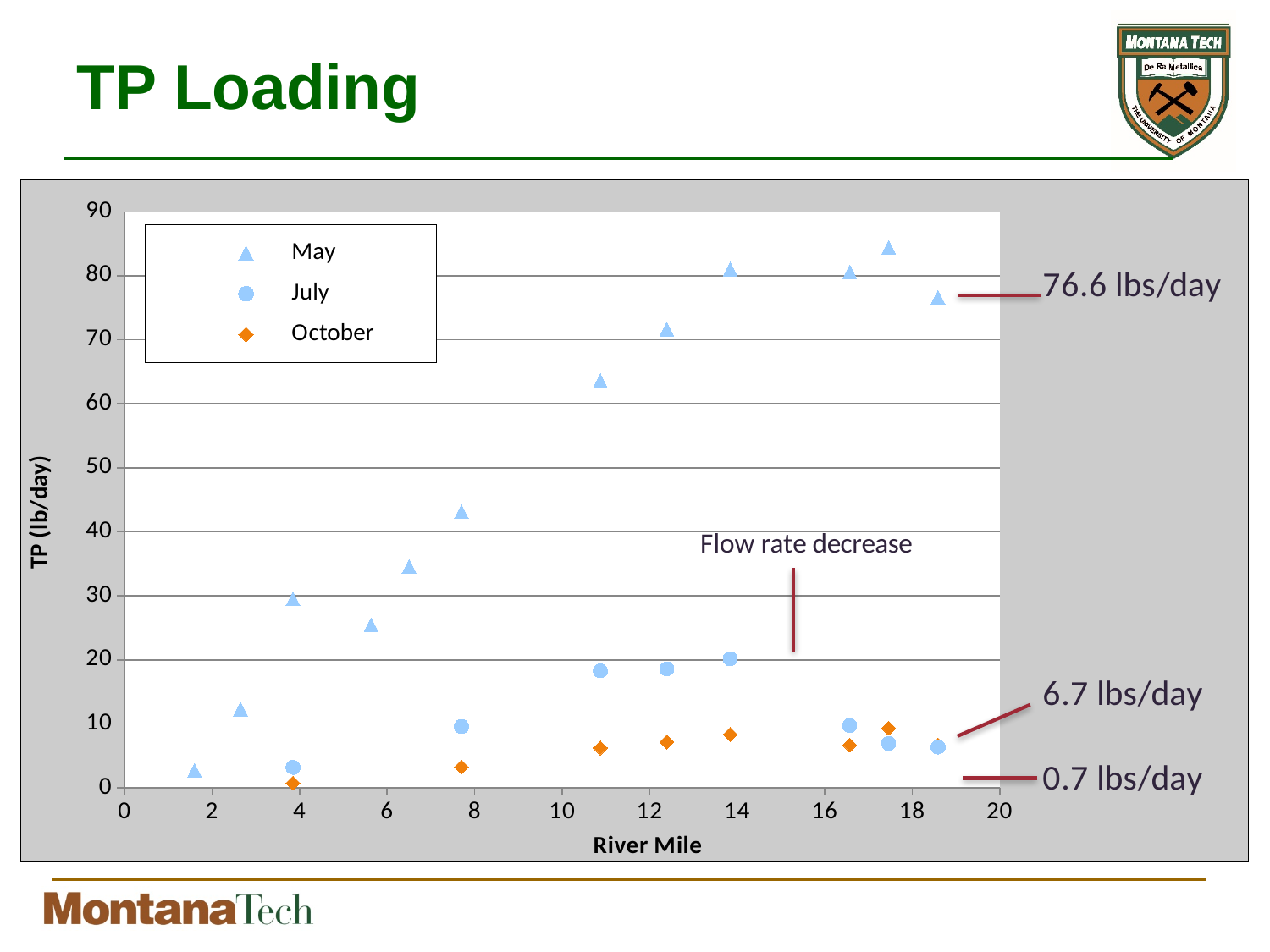
How many series does the legend list? 3 Which series has the highest TP loading values overall? May What kind of chart is shown on the slide? Scatter chart Do the May TP loading values generally rise or fall as river mile increases? rise Is the May value at about river mile 17.5 greater or less than 80? greater What is the difference between the annotated May value (76.6 lbs/day) and the annotated July value (6.7 lbs/day)? 69.9 lbs/day What is the label of the y axis? TP (lb/day) Are the October TP loading values greater or less than 10 lb/day? less What is the lowest TP loading value annotated on the chart? 0.7 lbs/day Which months are listed in the chart legend? May, July, October